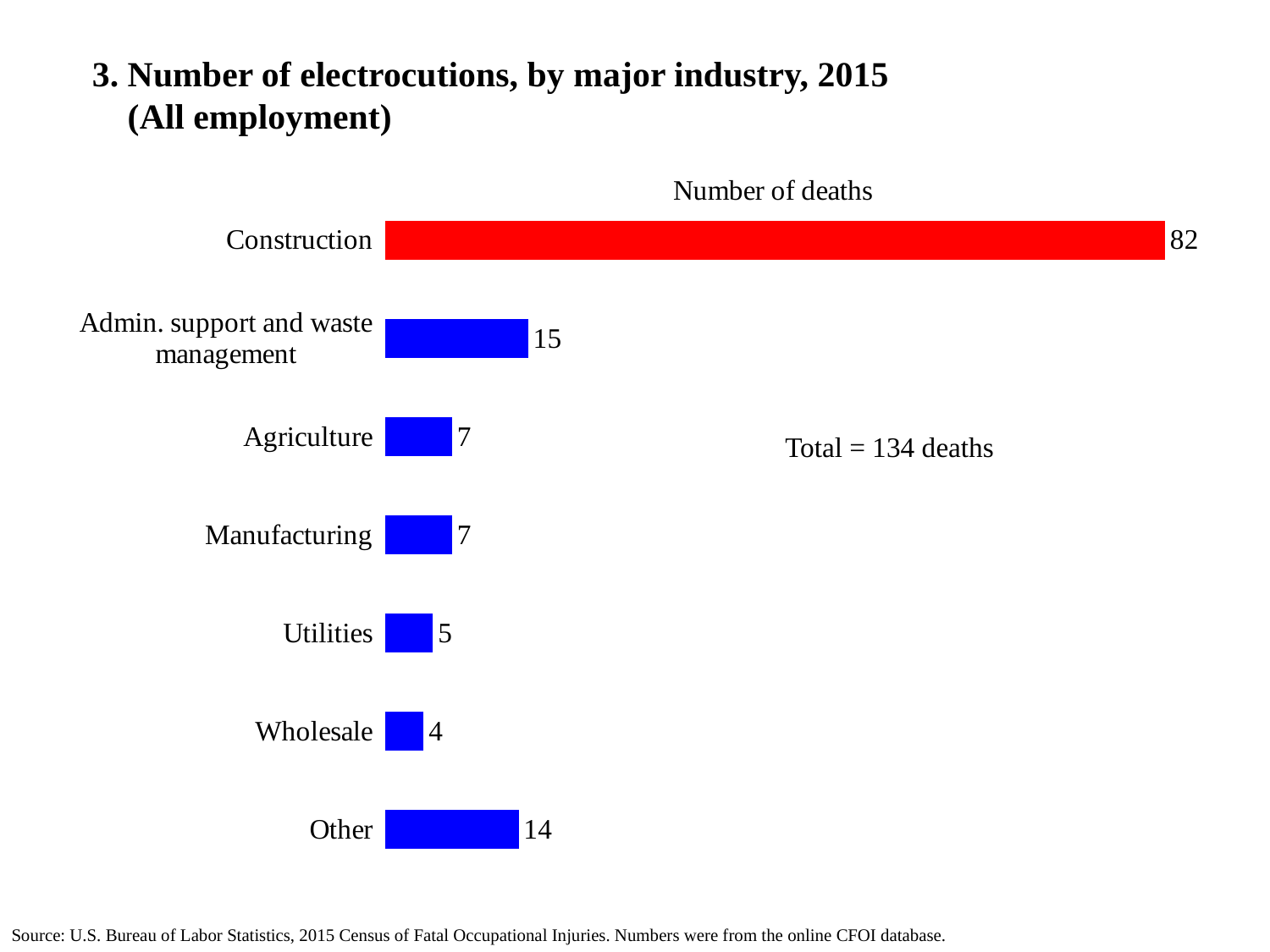
What total number of deaths is stated on the slide? 134 deaths How many industry categories are shown in the chart? 7 Which industry has the lowest number of deaths? Wholesale How many electrocution deaths are shown for Construction? 82 What kind of chart is shown on the slide? Bar chart What is the number of deaths for Admin. support and waste management? 15 What is the number of deaths for Utilities? 5 What is the difference in deaths between Construction and Admin. support and waste management? 67 Which has more deaths, Admin. support and waste management or Other? Admin. support and waste management What is the difference in deaths between Other and Wholesale? 10 What is the number of deaths for Other? 14 Which industry has the highest number of deaths? Construction